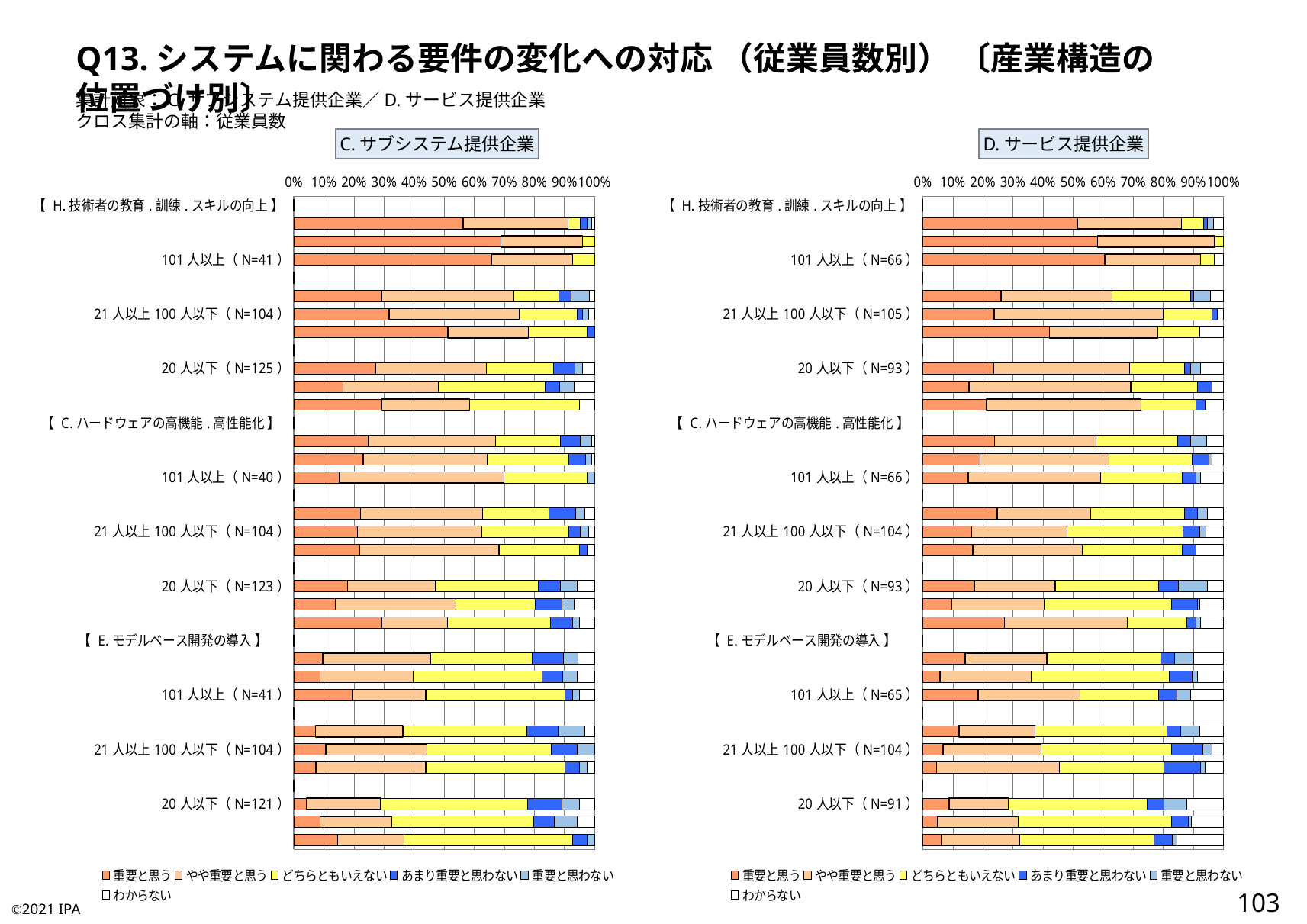
How many series does the legend of the left chart (C. サブシステム提供企業) list? 6 In the left chart (C. サブシステム提供企業), how many question categories (the bracketed headings) are shown? 3 What is the title of the right chart? D. サービス提供企業 How many series does the legend of the right chart (D. サービス提供企業) list? 6 In the left chart (C. サブシステム提供企業), is the 重要と思う share for the bar labelled 20 人以下 (N=121) under E. モデルベース開発の導入 greater or less than 10%? less What is the maximum value shown on the x axis of the left chart (C. サブシステム提供企業)? 100% What is the title of the left chart? C. サブシステム提供企業 In the right chart (D. サービス提供企業), how many employee-size groups are shown under each bracketed heading? 3 In the right chart (D. サービス提供企業), is the 重要と思う share for the bar labelled 101 人以上 (N=66) under H. 技術者の教育.訓練.スキルの向上 greater or less than 50%? greater What kind of chart is used on this slide? Stacked bar chart In the left chart (C. サブシステム提供企業), is the 重要と思う share for the bar labelled 101 人以上 (N=41) under H. 技術者の教育.訓練.スキルの向上 greater or less than 50%? greater